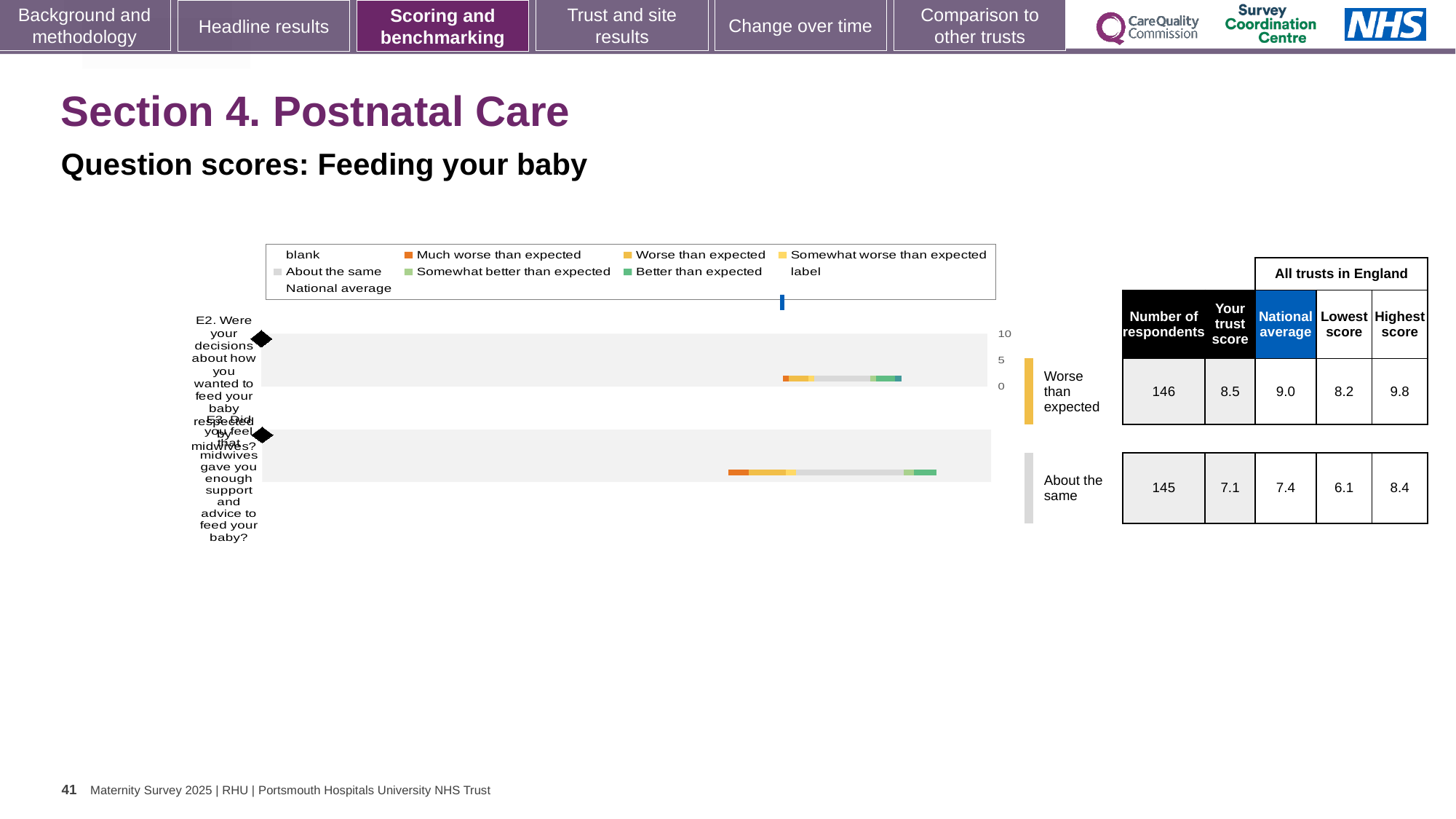
Which is larger for question E3: the trust score or the national average? National average Which benchmark category is question E3 about support and advice to feed your baby placed in? About the same What is the highest score among all trusts in England for question E2? 9.8 How many questions (categories) are plotted in the Feeding your baby chart? 2 What is the difference between the national average and the trust score for question E2? 0.5 What kind of chart is used to show the question scores for Feeding your baby? bar chart What is the trust score for question E2 about decisions on how you wanted to feed your baby being respected by midwives? 8.5 What is the lowest score among all trusts in England for question E3? 6.1 How many respondents answered question E3 about support and advice to feed your baby? 145 What is the trust score for question E3 about midwives giving enough support and advice to feed your baby? 7.1 What colour in the legend represents 'Much worse than expected'? Orange What is the national average for question E2 about feeding decisions being respected by midwives? 9.0